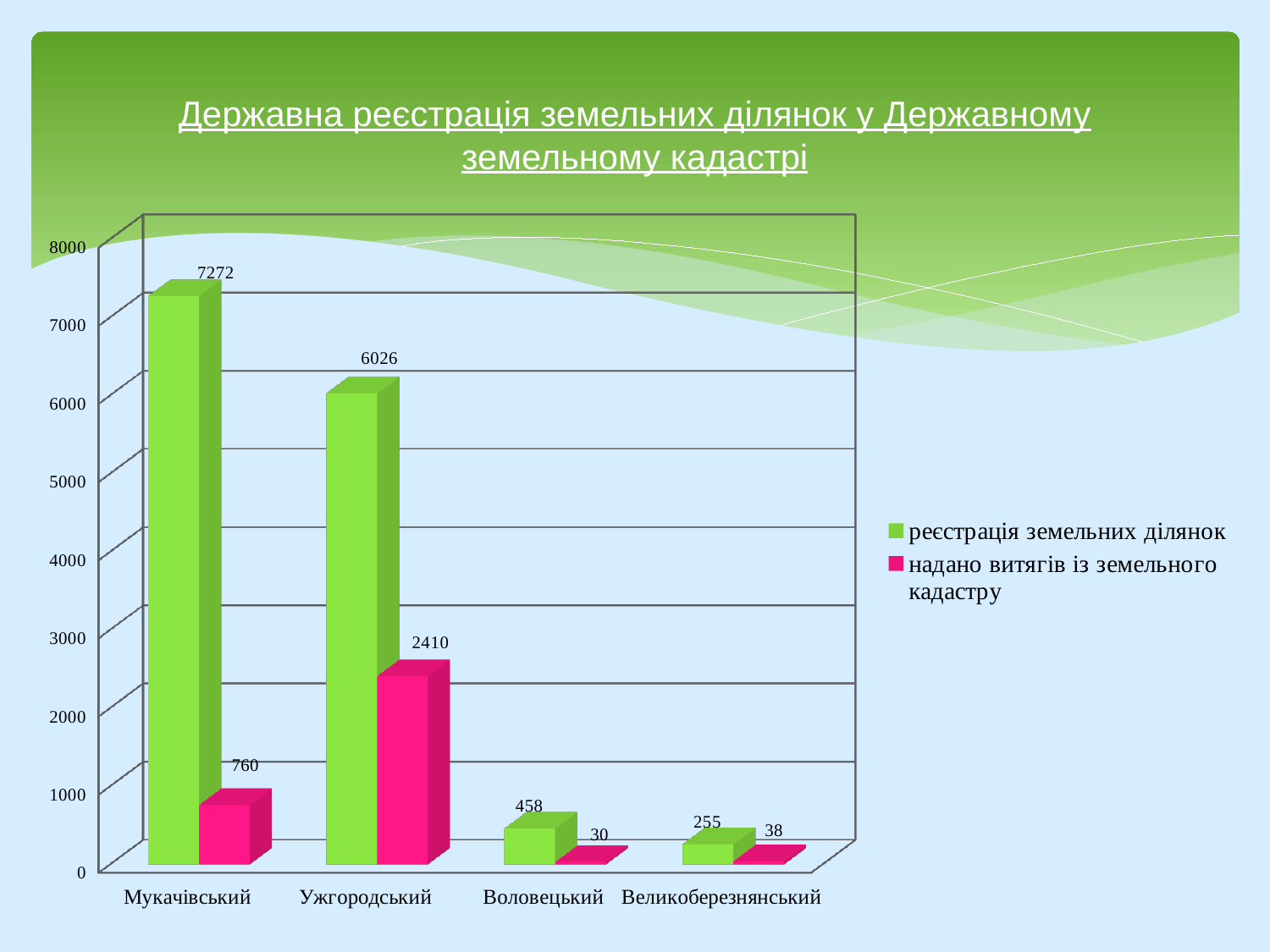
Is the value of реєстрація земельних ділянок for Ужгородський greater or less than 5000? greater What kind of chart is shown on the slide? bar chart Which category has the lowest value for надано витягів із земельного кадастру? Воловецький What is the difference between реєстрація земельних ділянок for Мукачівський and Ужгородський? 1246 What is the value of реєстрація земельних ділянок for Мукачівський? 7272 How many categories are shown on the x axis? 4 What is the value of надано витягів із земельного кадастру for Ужгородський? 2410 Which is larger: надано витягів із земельного кадастру for Мукачівський or for Ужгородський? Ужгородський Which category has the highest value for реєстрація земельних ділянок? Мукачівський What colour represents the series надано витягів із земельного кадастру? pink How many series does the legend list? 2 What is the value of надано витягів із земельного кадастру for Воловецький? 30